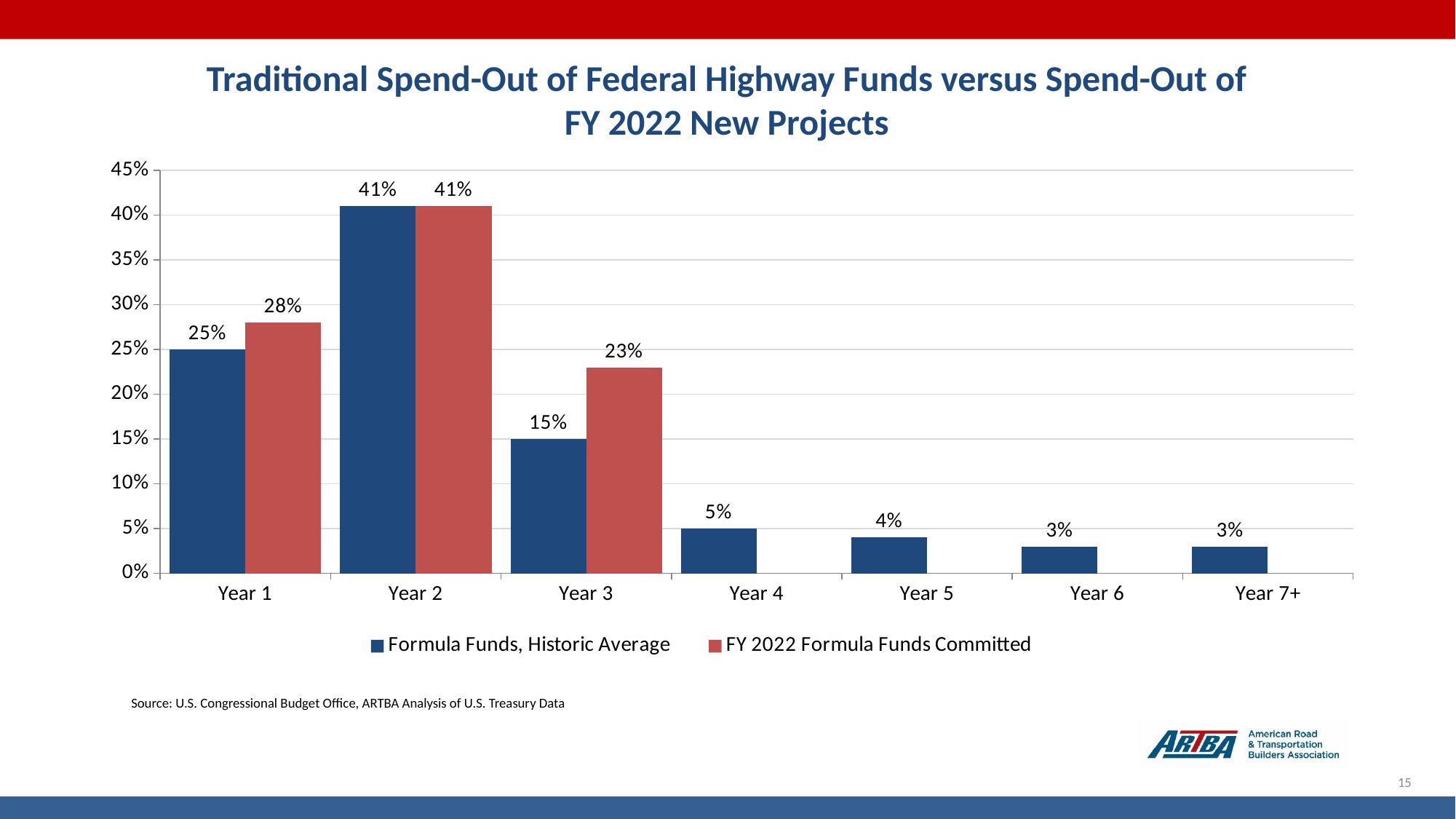
In Year 1, which series has the larger value: Formula Funds, Historic Average or FY 2022 Formula Funds Committed? FY 2022 Formula Funds Committed What is the difference between FY 2022 Formula Funds Committed and Formula Funds, Historic Average in Year 3? 8% How many series does the legend list? 2 Is the value for Formula Funds, Historic Average in Year 4 greater or less than 10%? less What is the value for Formula Funds, Historic Average in Year 7+? 3% What kind of chart is shown on the slide? Bar chart Which year has the highest value for Formula Funds, Historic Average? Year 2 How many year categories are shown on the x axis? 7 What is the value for FY 2022 Formula Funds Committed in Year 3? 23% Which year has the lowest value for FY 2022 Formula Funds Committed among the years where it is plotted? Year 3 Does the Formula Funds, Historic Average series rise or fall from Year 2 to Year 7+? Fall What is the value for Formula Funds, Historic Average in Year 1? 25%